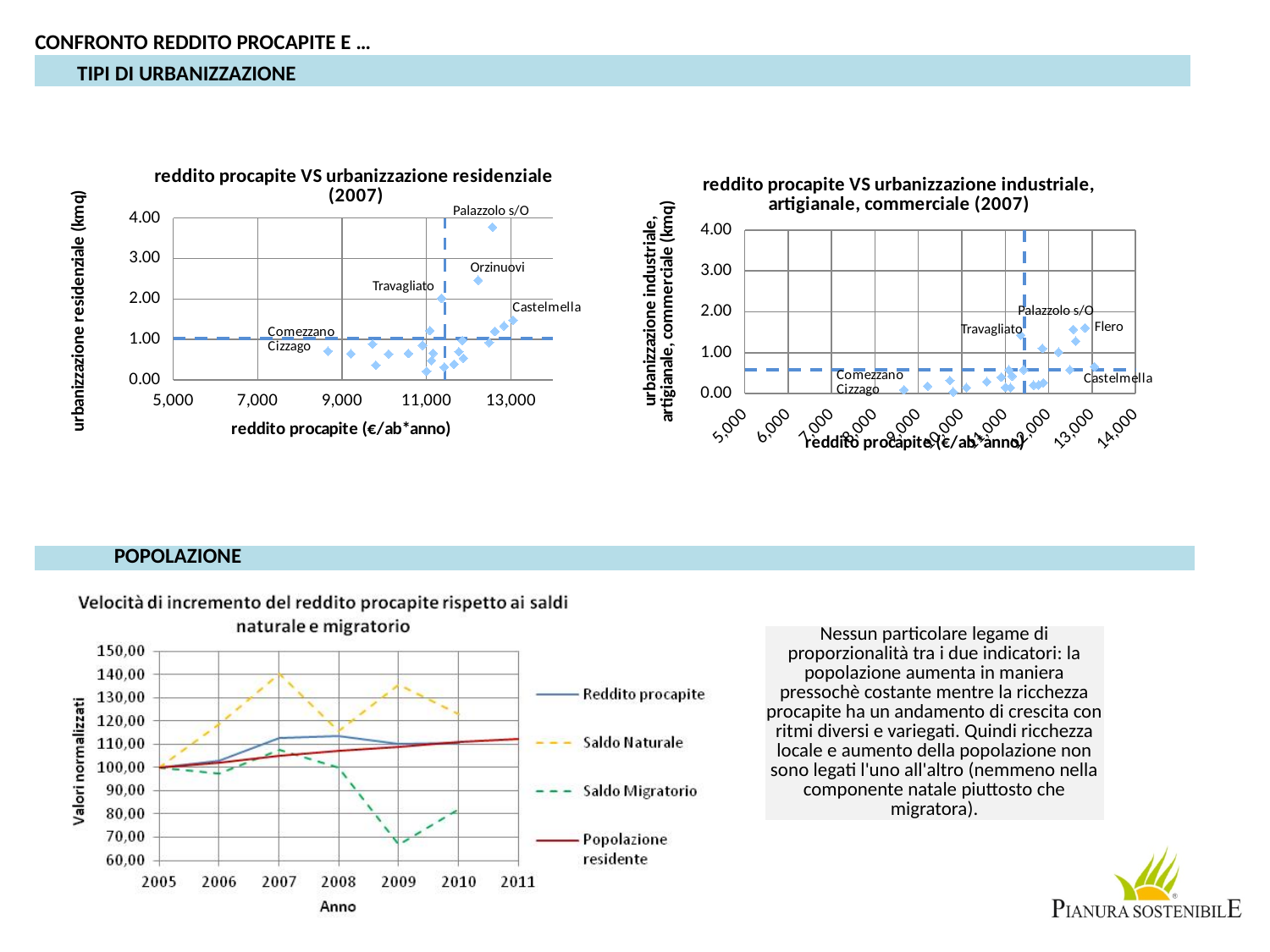
In the 'reddito procapite VS urbanizzazione residenziale (2007)' chart, is the residential urbanization value for Comezzano Cizzago greater or less than 1.00? less How many series does the legend of the 'Velocità di incremento del reddito procapite rispetto ai saldi naturale e migratorio' chart list? 4 In the 'reddito procapite VS urbanizzazione industriale, artigianale, commerciale (2007)' chart, is the value for Flero greater or less than 1.00? greater In the 'Velocità di incremento del reddito procapite rispetto ai saldi naturale e migratorio' chart, is the Saldo Naturale value in 2007 greater or less than 130,00? greater What is the x-axis title of the 'reddito procapite VS urbanizzazione residenziale (2007)' chart? reddito procapite (€/ab*anno) In the 'reddito procapite VS urbanizzazione residenziale (2007)' chart, which has the higher residential urbanization value, Orzinuovi or Castelmella? Orzinuovi In the 'reddito procapite VS urbanizzazione residenziale (2007)' chart, which labelled municipality has the highest residential urbanization value? Palazzolo s/O In the 'Velocità di incremento del reddito procapite rispetto ai saldi naturale e migratorio' chart, in which year does Saldo Migratorio reach its lowest value? 2009 What kind of chart is the 'reddito procapite VS urbanizzazione residenziale (2007)' chart? scatter chart In the 'Velocità di incremento del reddito procapite rispetto ai saldi naturale e migratorio' chart, does the Popolazione residente series rise or fall from 2005 to 2011? rise